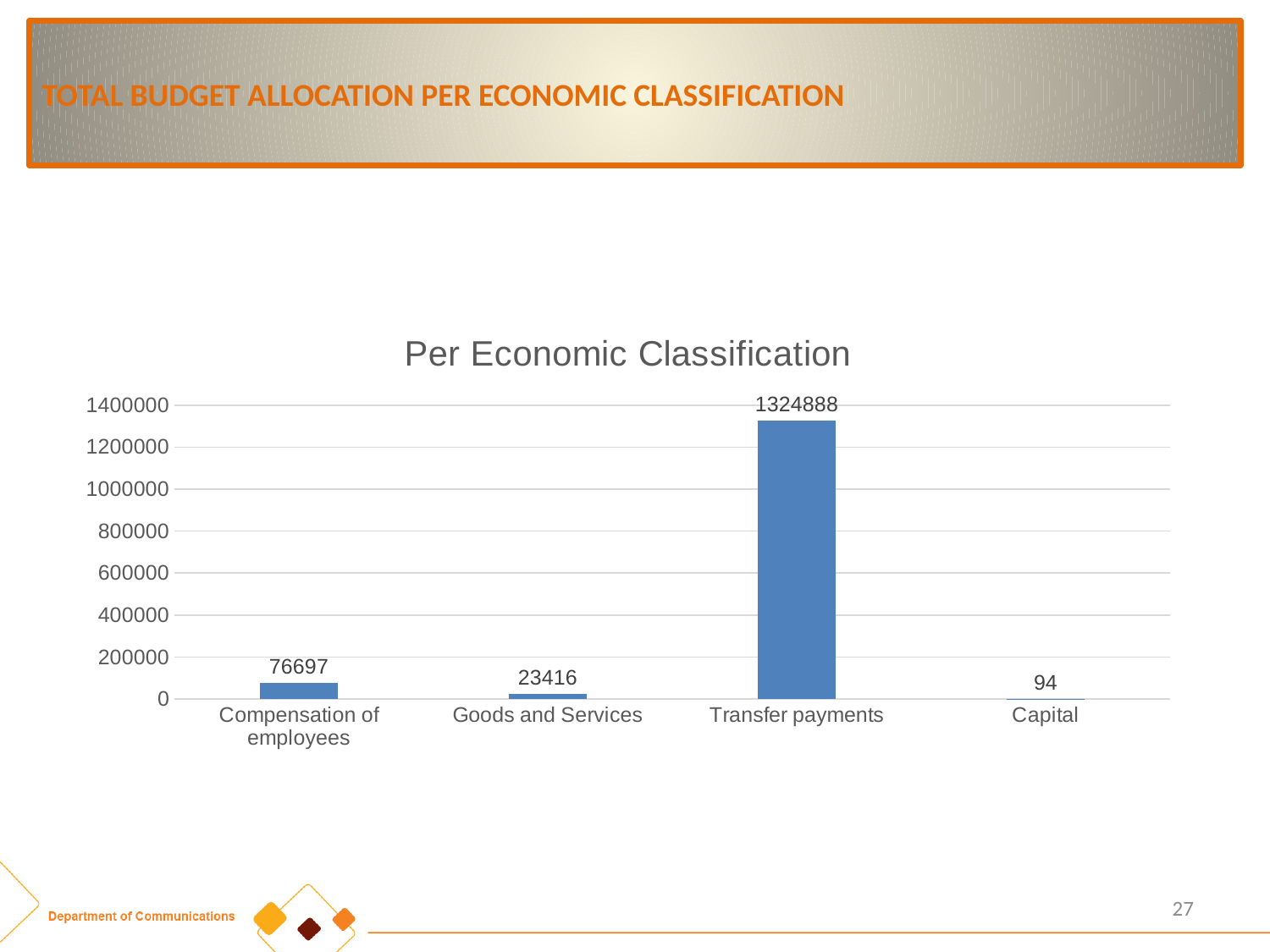
Which category has the lowest value? Capital What kind of chart is shown on the slide? bar chart What is the title of the chart? Per Economic Classification What is the value for Goods and Services? 23416 Is the value for Transfer payments greater or less than 1200000? greater Which is larger, the value for Compensation of employees or the value for Goods and Services? Compensation of employees How many categories are shown on the x axis? 4 What is the difference between the values for Compensation of employees and Goods and Services? 53281 What is the value for Compensation of employees? 76697 What is the value for Capital? 94 Which category has the highest value? Transfer payments What is the value for Transfer payments? 1324888